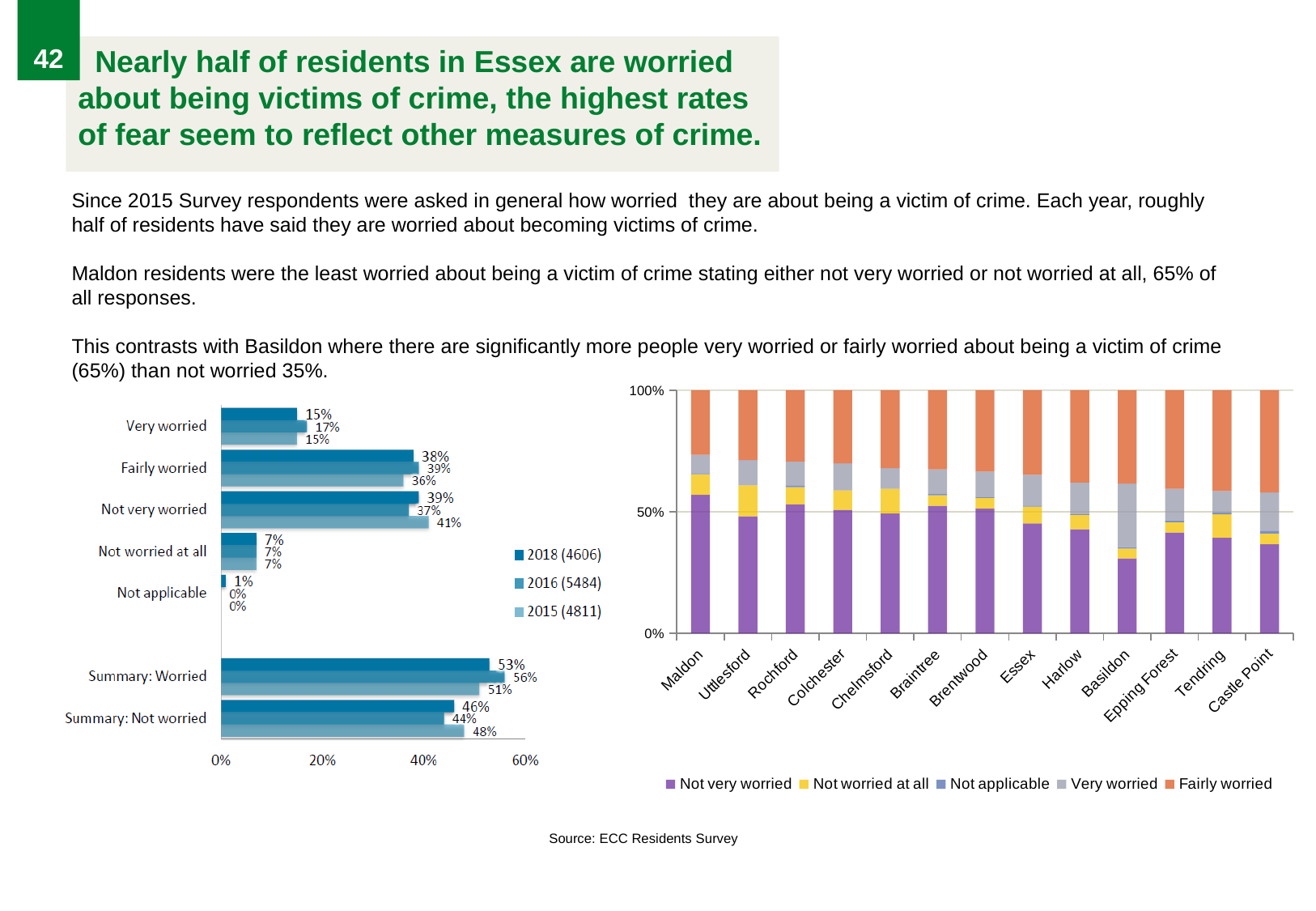
On the left chart, what is the 2016 (5484) value for Summary: Worried? 56% How many series does the legend of the left chart list? 3 On the right chart, is the Not very worried value for Basildon greater or less than 50%? less On the left chart, what is the difference between the 2018 (4606) and 2015 (4811) values for Summary: Worried? 2% On the left chart, what is the 2015 (4811) value for Not very worried? 41% On the left chart, which year has the highest value for Summary: Not worried? 2015 (4811) How many districts are shown on the x axis of the right chart? 13 What kind of chart is the chart on the right? stacked bar chart On the right chart, which colour represents Fairly worried in the legend? orange On the right chart, is the Not very worried value for Maldon greater or less than 50%? greater On the left chart, is the 2016 (5484) value for Very worried larger or smaller than the 2018 (4606) value? larger On the left chart, what is the 2018 (4606) value for Fairly worried? 38%